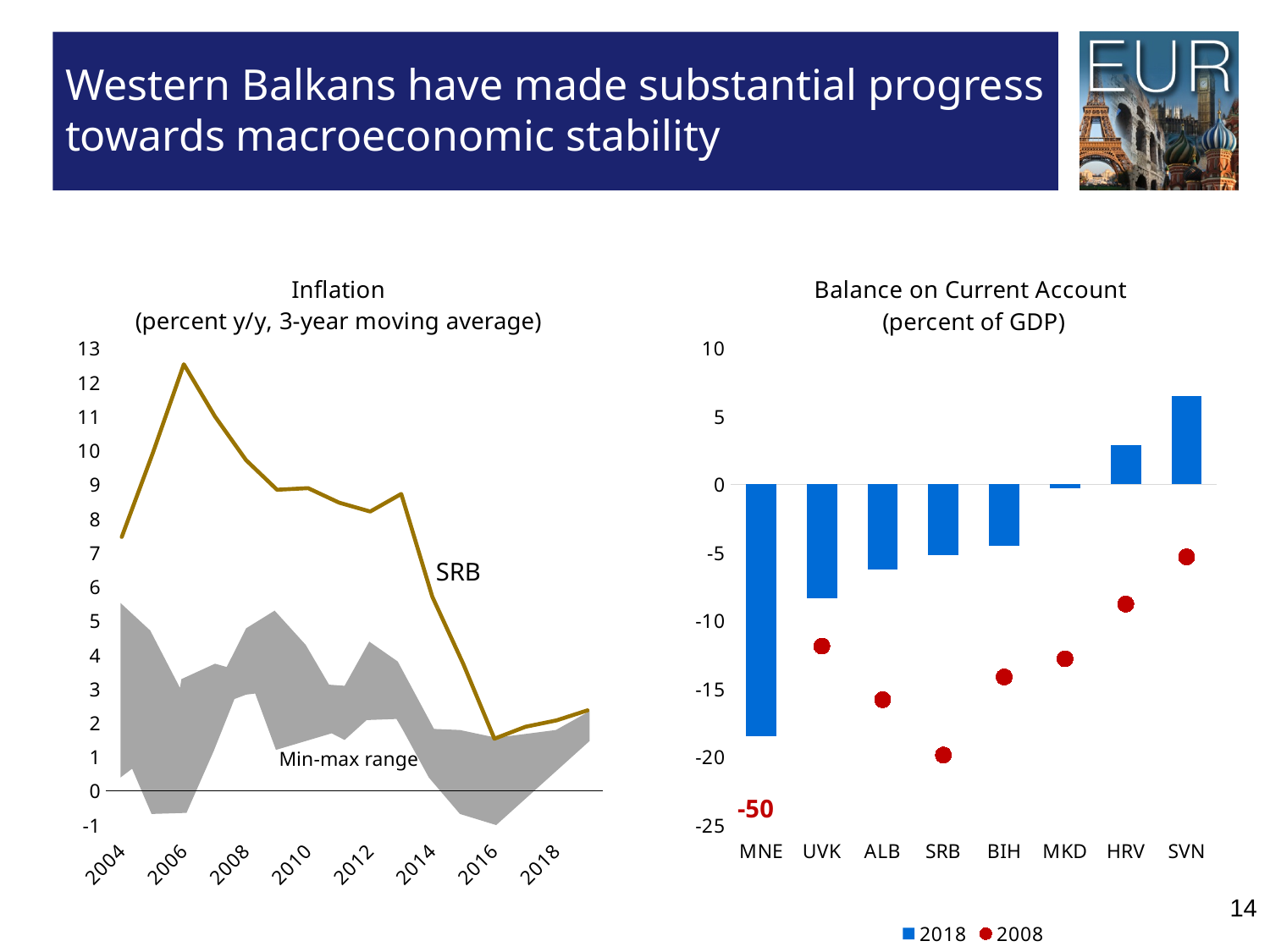
In the Inflation chart, what is the label of the grey shaded area? Min-max range In the Balance on Current Account chart, which country has the highest 2018 value? SVN In the Balance on Current Account chart, is the 2018 value for MNE greater or less than -15? less What kind of chart is the Balance on Current Account chart? combination chart (bars for 2018 and dots for 2008) In the Inflation chart, does the SRB line rise or fall between 2006 and 2016? fall How many series does the legend of the Balance on Current Account chart list? 2 In the Balance on Current Account chart, is the 2018 value for SVN greater or less than 5? greater In the Balance on Current Account chart, which is larger, the 2018 value for UVK or the 2018 value for ALB? ALB What kind of chart is the Inflation chart? line chart In the Balance on Current Account chart, which country has the lowest 2018 value? MNE In the Balance on Current Account chart, what is the 2008 value for MNE? -50 How many countries are shown on the x axis of the Balance on Current Account chart? 8